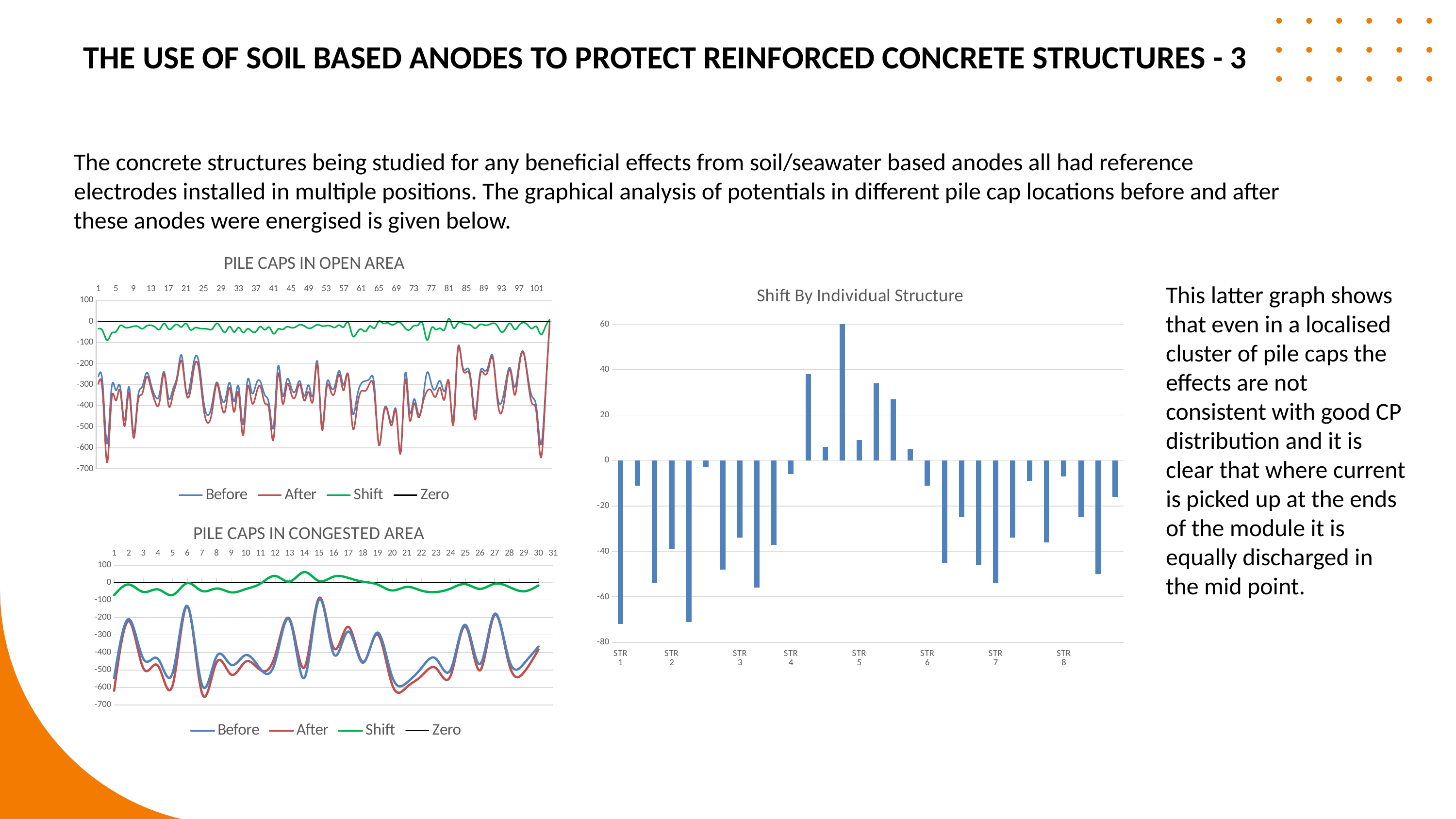
In "Shift By Individual Structure", how many structure groups are labelled on the x axis? 8 In "Shift By Individual Structure", is the tallest bar greater or less than 40? greater What kind of chart is "PILE CAPS IN OPEN AREA"? Line chart In "PILE CAPS IN CONGESTED AREA", is the Shift value at point 14 greater or less than 0? greater What are the legend entries of "PILE CAPS IN OPEN AREA"? Before, After, Shift, Zero What colour is the Shift series in "PILE CAPS IN OPEN AREA"? Green In "PILE CAPS IN OPEN AREA", is the Before value at point 1 greater or less than -100? less How many series does the legend of "PILE CAPS IN CONGESTED AREA" list? 4 What kind of chart is "Shift By Individual Structure"? Bar chart